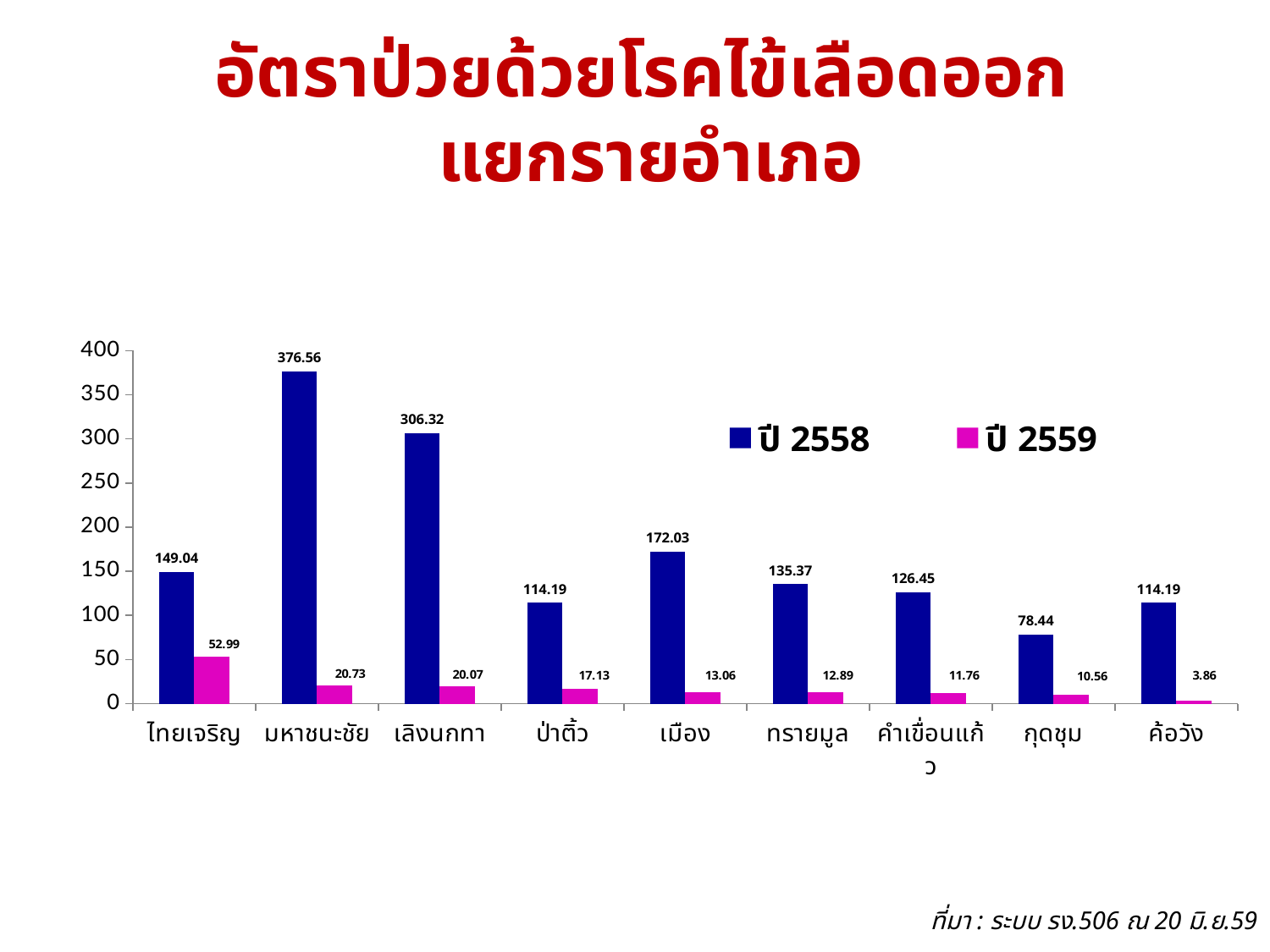
What is the difference between the ปี 2558 and ปี 2559 values in เลิงนกทา? 286.25 What is the value for ปี 2559 in ไทยเจริญ? 52.99 Is the ปี 2558 value for คำเขื่อนแก้ว greater or less than 100? greater What kind of chart is shown on the slide? bar chart How many series does the legend list? 2 Which colour represents ปี 2559 in the legend? magenta Which district has the highest value for ปี 2558? มหาชนะชัย How many districts are shown on the x axis? 9 Which district has the lowest value for ปี 2559? ค้อวัง Which is larger: the ปี 2558 value for เมือง or for ทรายมูล? เมือง What is the value for ปี 2558 in มหาชนะชัย? 376.56 What is the value for ปี 2558 in กุดชุม? 78.44